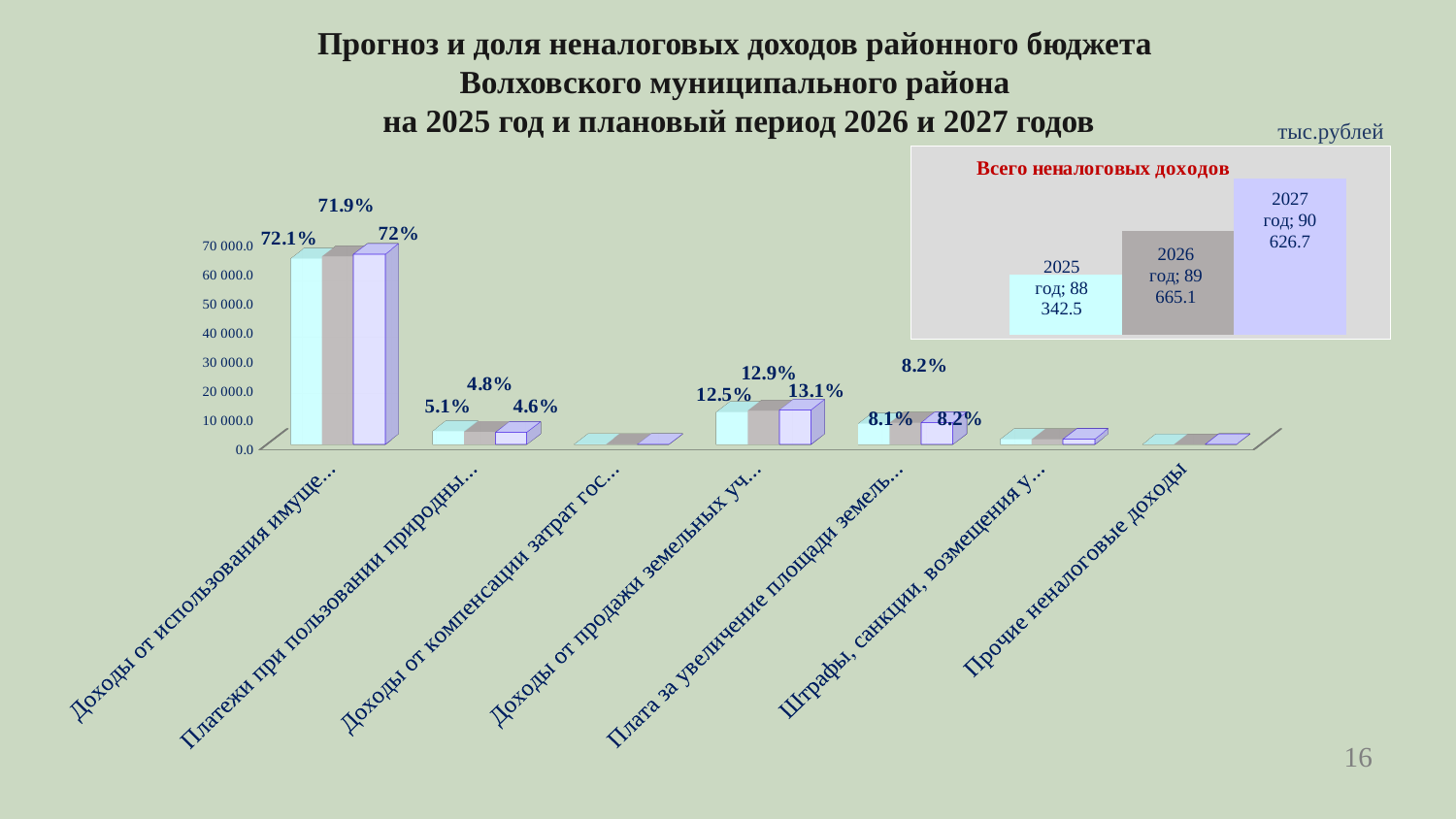
In the inset chart titled 'Всего неналоговых доходов', what is the value for 2027 год? 90 626.7 In the main chart on the left, what percentage label is shown on the first (leftmost) bar of the category 'Доходы от использования имуще...'? 72.1% In the inset chart titled 'Всего неналоговых доходов', which year has the highest value? 2027 год In the inset chart titled 'Всего неналоговых доходов', which year has the lowest value? 2025 год In the inset chart titled 'Всего неналоговых доходов', how many bars are shown? 3 In the inset chart titled 'Всего неналоговых доходов', do the values rise or fall from 2025 to 2027? rise In the main chart on the left, is the value of the first bar for 'Доходы от использования имуще...' greater or less than 60 000.0? greater In the main chart on the left, how many categories are shown on the x axis? 7 In the inset chart titled 'Всего неналоговых доходов', what is the value for 2025 год? 88 342.5 In the main chart on the left, what kind of chart is it? bar chart In the inset chart titled 'Всего неналоговых доходов', what is the difference between the 2027 год and 2025 год values? 2 284.2 In the main chart on the left, what percentage label is shown on the third bar of the category 'Доходы от продажи земельных уч...'? 13.1%